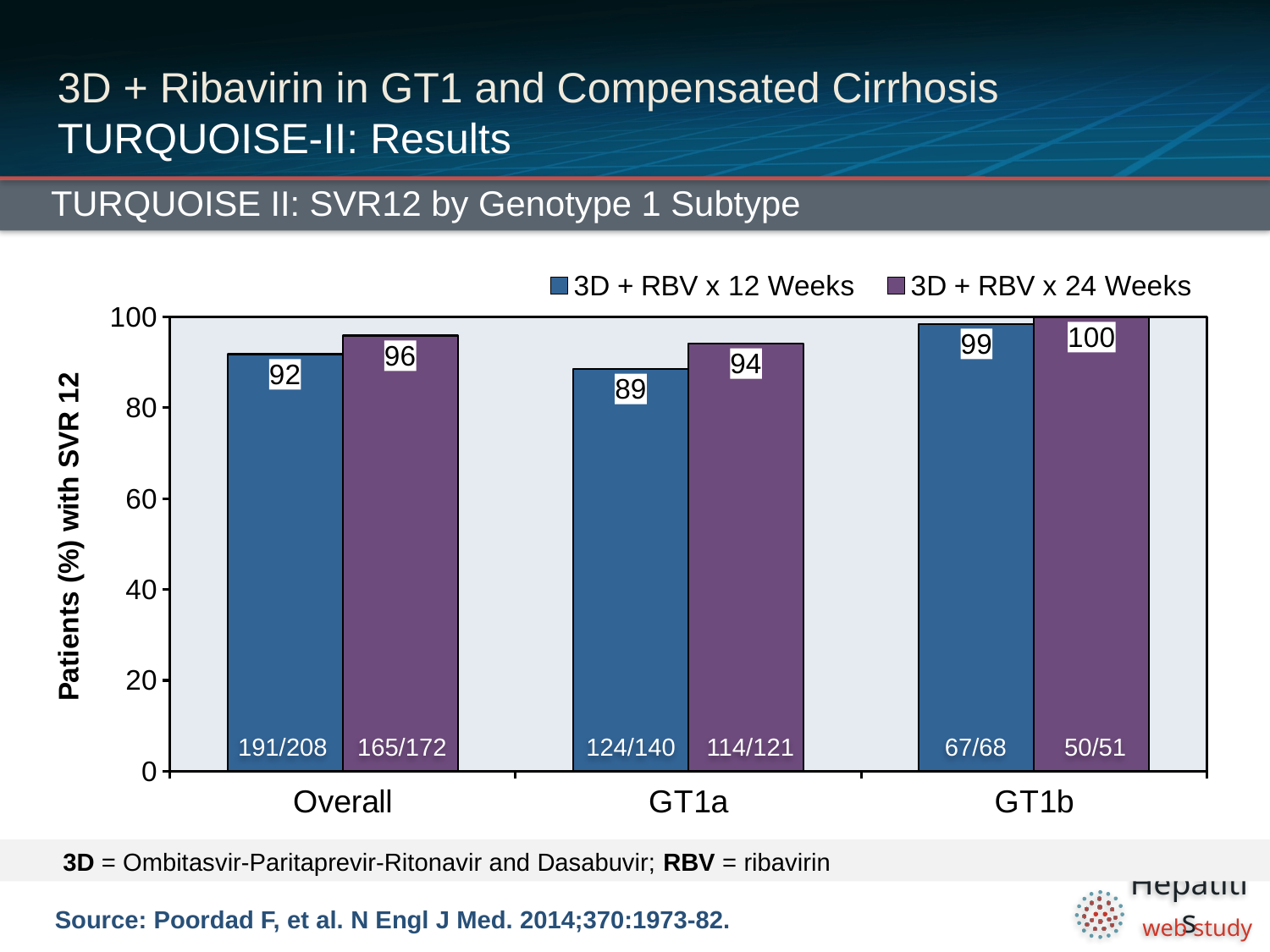
How many genotype categories are shown on the x axis? 3 What fraction of patients is shown for the 3D + RBV x 24 Weeks group in the Overall category? 165/172 What is the SVR12 rate for the 3D + RBV x 24 Weeks group in the GT1a category? 94 What type of chart is shown on the slide? Bar chart What is the SVR12 rate for the 3D + RBV x 12 Weeks group in the Overall category? 92 What is the label of the y axis? Patients (%) with SVR 12 How many series does the legend list? 2 In the Overall category, which group has the higher SVR12 rate: 3D + RBV x 12 Weeks or 3D + RBV x 24 Weeks? 3D + RBV x 24 Weeks What is the SVR12 rate for the 3D + RBV x 12 Weeks group in the GT1b category? 99 What is the difference in SVR12 rate between the 24-week and 12-week groups in the GT1a category? 5 Which genotype category has the lowest SVR12 rate for the 3D + RBV x 12 Weeks group? GT1a Which category has the highest SVR12 rate for the 3D + RBV x 24 Weeks group? GT1b